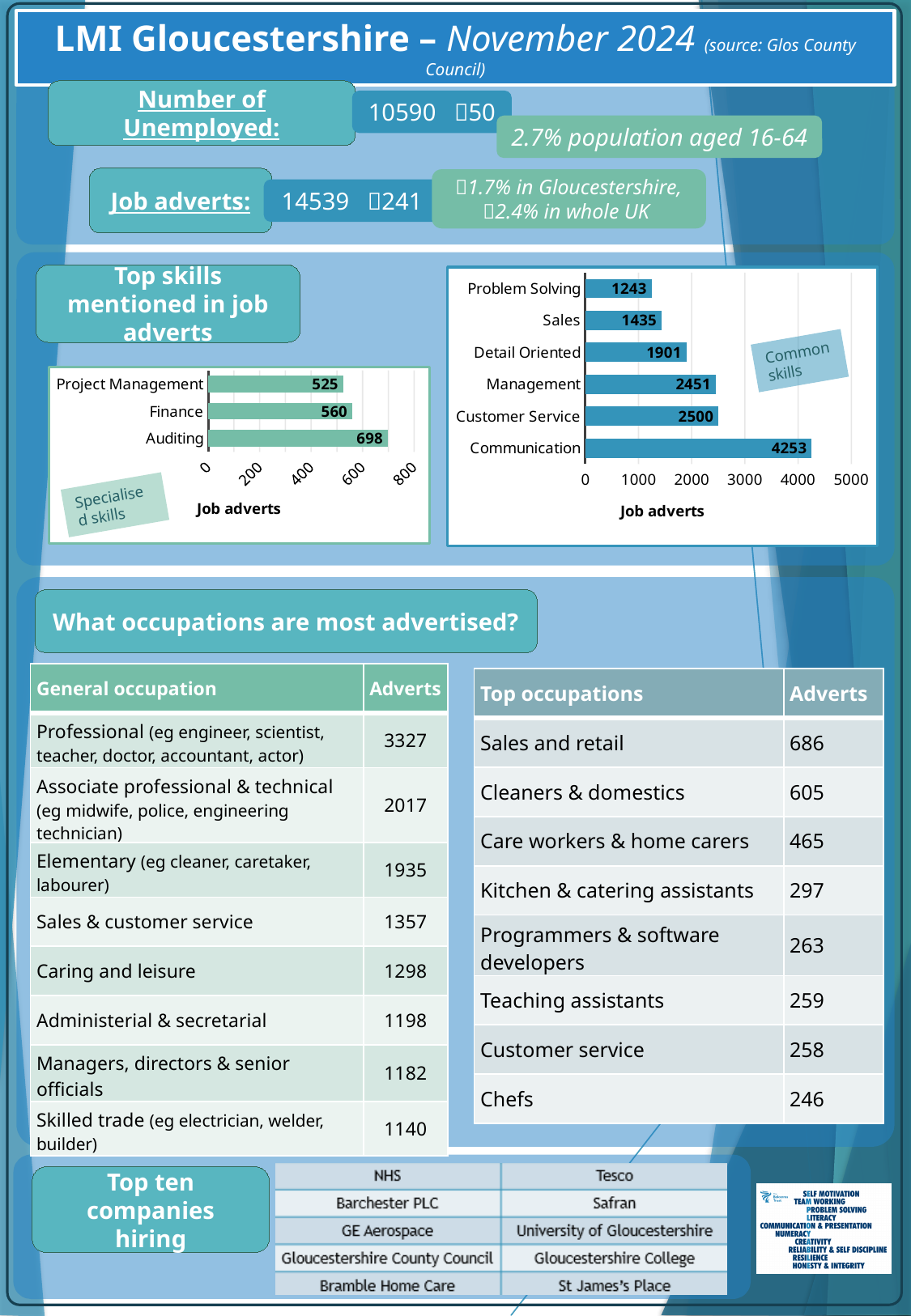
In the Specialised skills chart on the left, which skill has the highest number of job adverts? Auditing In the Specialised skills chart on the left, what is the difference in job adverts between Auditing and Project Management? 173 In the Common skills chart on the right, how many job adverts mention Detail Oriented? 1901 In the Common skills chart on the right, what is the difference in job adverts between Communication and Customer Service? 1753 In the Specialised skills chart on the left, how many job adverts mention Finance? 560 In the Common skills chart on the right, which has more job adverts, Sales or Management? Management What type of chart is the Common skills chart on the right? Bar chart How many skills are shown in the Common skills chart on the right? 6 In the Common skills chart on the right, which skill has the highest number of job adverts? Communication In the Common skills chart on the right, which skill has the lowest number of job adverts? Problem Solving How many skills are shown in the Specialised skills chart on the left? 3 In the Common skills chart on the right, how many job adverts mention Communication? 4253